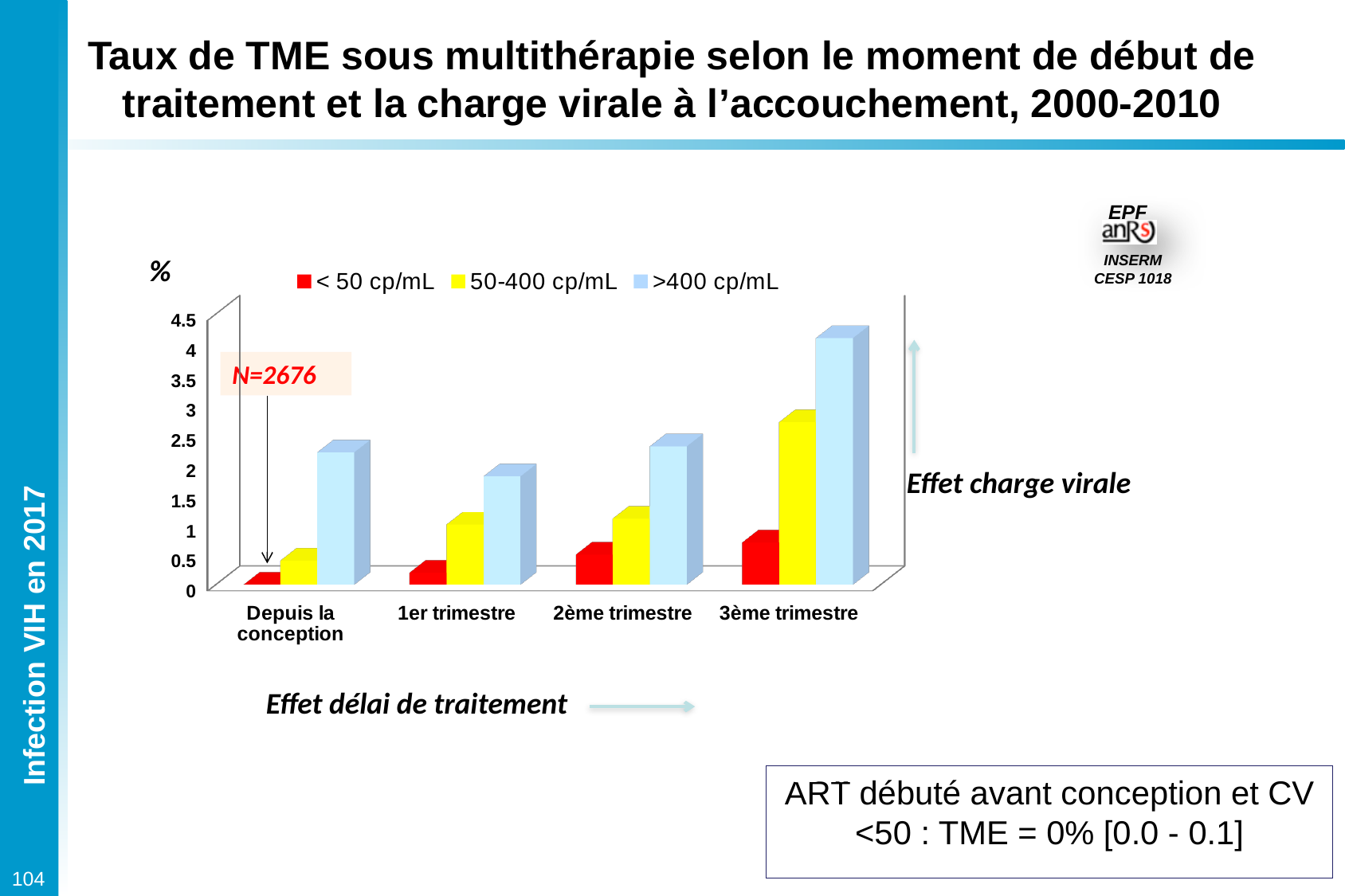
Which is larger for the >400 cp/mL series: 2ème trimestre or 3ème trimestre? 3ème trimestre Is the value for >400 cp/mL in the 3ème trimestre category greater or less than 3? greater Which category has the tallest bar for the >400 cp/mL series? 3ème trimestre Do the values for the < 50 cp/mL series rise or fall from Depuis la conception to 3ème trimestre? rise Is the value for 50-400 cp/mL in the 3ème trimestre category greater or less than 2? greater Which category has the lowest value for the < 50 cp/mL series? Depuis la conception How many series does the legend list? 3 Is the value for < 50 cp/mL in the Depuis la conception category greater or less than 0.5? less What kind of chart is shown on the slide? bar chart What sample size (N) is annotated on the chart? N=2676 How many treatment-start categories are shown on the x axis? 4